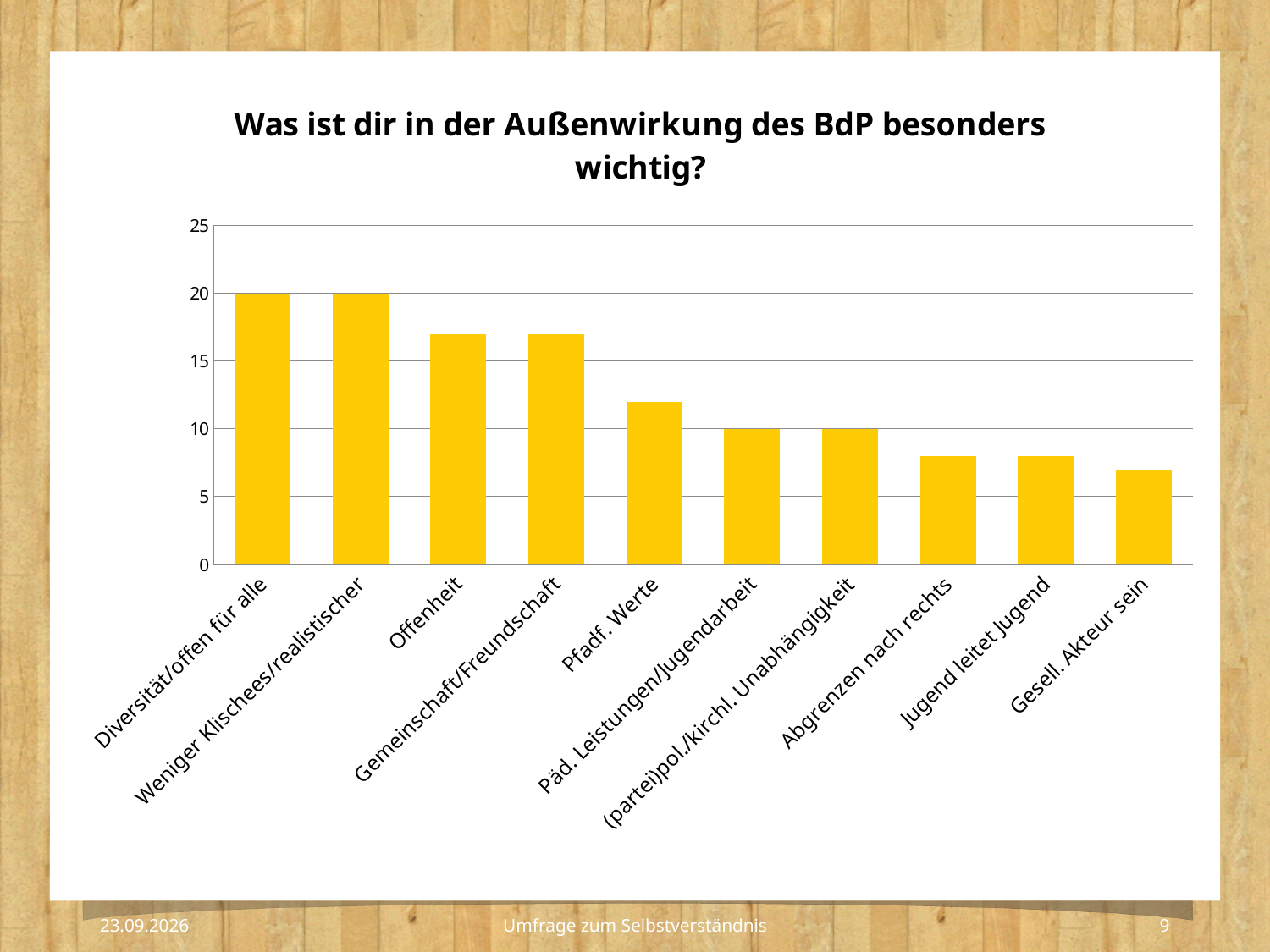
Do the values generally rise or fall from left to right along the x axis? fall What is the value for (partei)pol./kirchl. Unabhängigkeit? 10 What is the value for Diversität/offen für alle? 20 Is the value for Gesell. Akteur sein greater or less than 10? less What is the value for Weniger Klischees/realistischer? 20 Is the value for Pfadf. Werte greater or less than 15? less What is the title of the chart? Was ist dir in der Außenwirkung des BdP besonders wichtig? Is the value for Offenheit greater or less than 15? greater What type of chart is shown on the slide? bar chart Which is larger, the value for Offenheit or the value for Pfadf. Werte? Offenheit How many categories are shown on the x axis of the chart? 10 What is the value for Päd. Leistungen/Jugendarbeit? 10